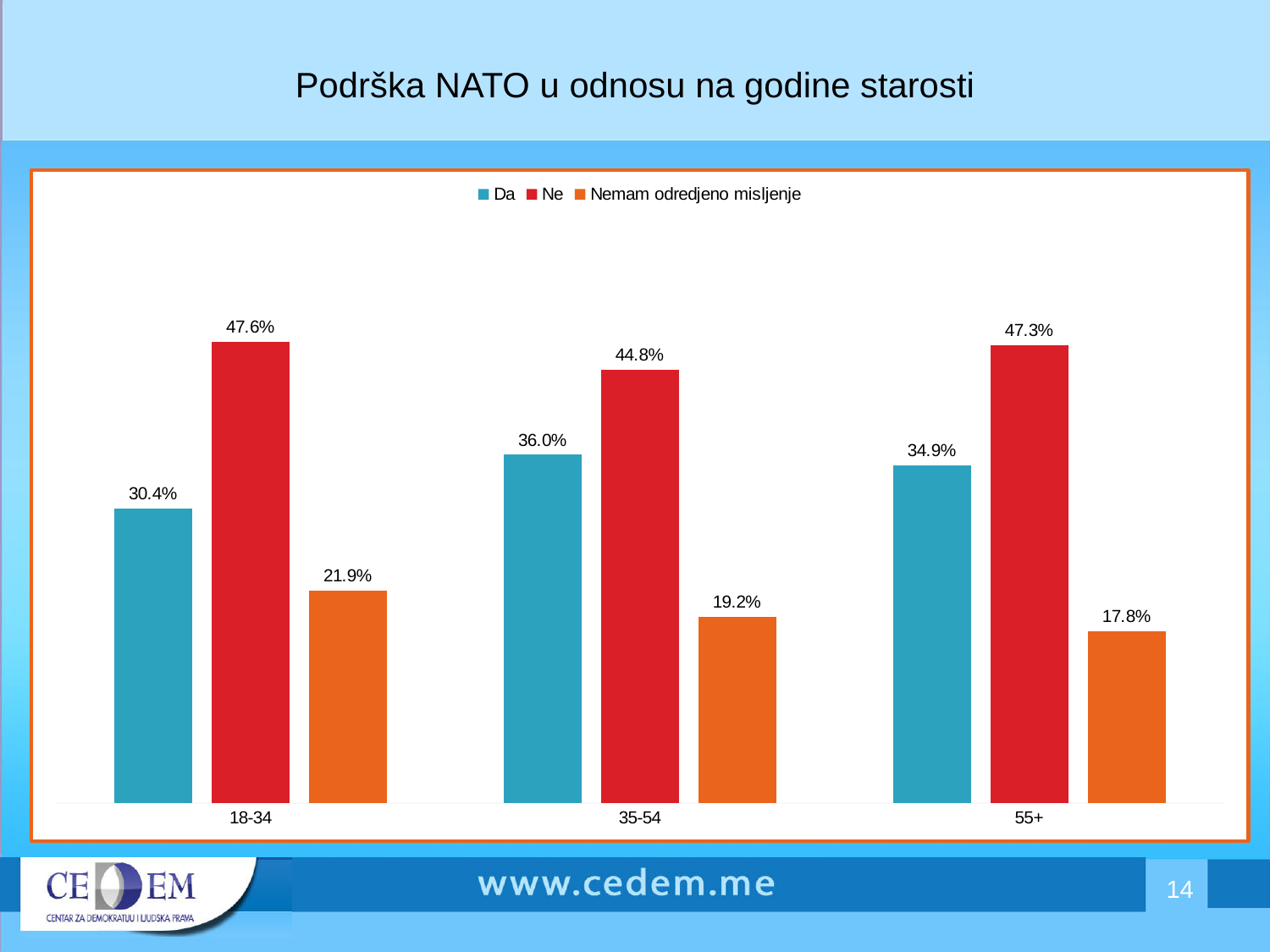
Which age group has the highest value for "Ne"? 18-34 What is the value for "Ne" in the 35-54 age group? 44.8% Do the values for "Nemam odredjeno misljenje" rise or fall from the 18-34 group to the 55+ group? Fall What kind of chart is shown on the slide? Bar chart What is the title of the chart? Podrška NATO u odnosu na godine starosti What is the value for "Da" in the 18-34 age group? 30.4% How many age groups are shown on the x axis? 3 Which is larger: "Da" for 35-54 or "Da" for 55+? Da for 35-54 How many series does the legend list? 3 What is the value for "Nemam odredjeno misljenje" in the 55+ age group? 17.8% What is the difference between "Ne" and "Da" in the 55+ age group? 12.4% Which age group has the lowest value for "Da"? 18-34